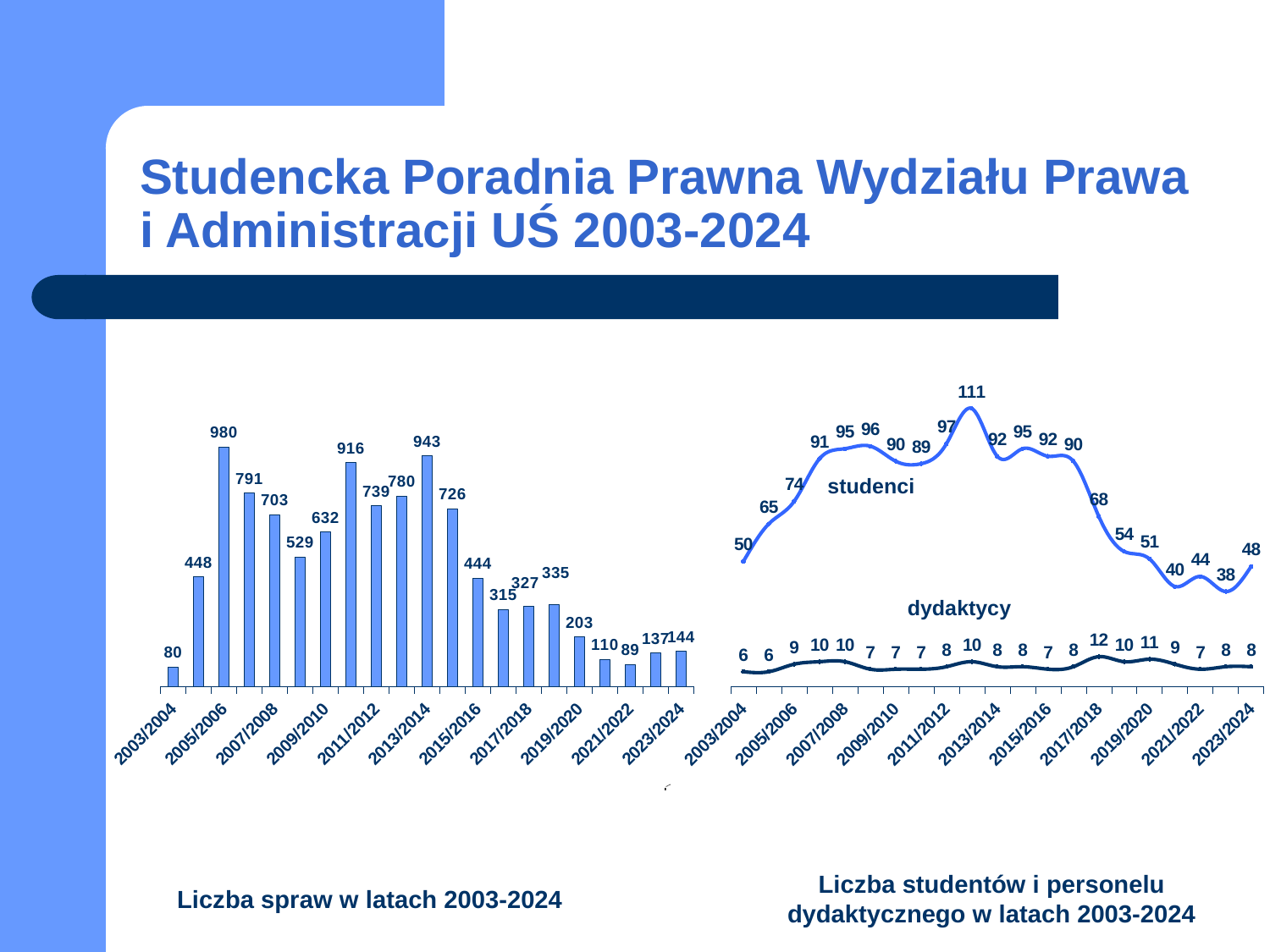
In the chart 'Liczba studentów i personelu dydaktycznego w latach 2003-2024', does the 'studenci' series rise or fall from 2017/2018 to 2021/2022? fall How many series are plotted in the chart 'Liczba studentów i personelu dydaktycznego w latach 2003-2024'? 2 In the chart 'Liczba studentów i personelu dydaktycznego w latach 2003-2024', what is the value of the 'studenci' series for 2003/2004? 50 In the chart 'Liczba spraw w latach 2003-2024', which year has the highest value? 2005/2006 In the chart 'Liczba spraw w latach 2003-2024', what is the difference between the values for 2013/2014 and 2015/2016? 499 In the chart 'Liczba studentów i personelu dydaktycznego w latach 2003-2024', what is the value of the 'dydaktycy' series for 2017/2018? 12 In the chart 'Liczba spraw w latach 2003-2024', what is the value for 2005/2006? 980 In the chart 'Liczba spraw w latach 2003-2024', which year has the lowest value? 2003/2004 What kind of chart is 'Liczba spraw w latach 2003-2024'? bar chart In the chart 'Liczba studentów i personelu dydaktycznego w latach 2003-2024', what is the highest value of the 'studenci' series? 111 In the chart 'Liczba spraw w latach 2003-2024', what is the value for 2023/2024? 144 In the chart 'Liczba spraw w latach 2003-2024', which is larger, the value for 2009/2010 or the value for 2011/2012? 2011/2012